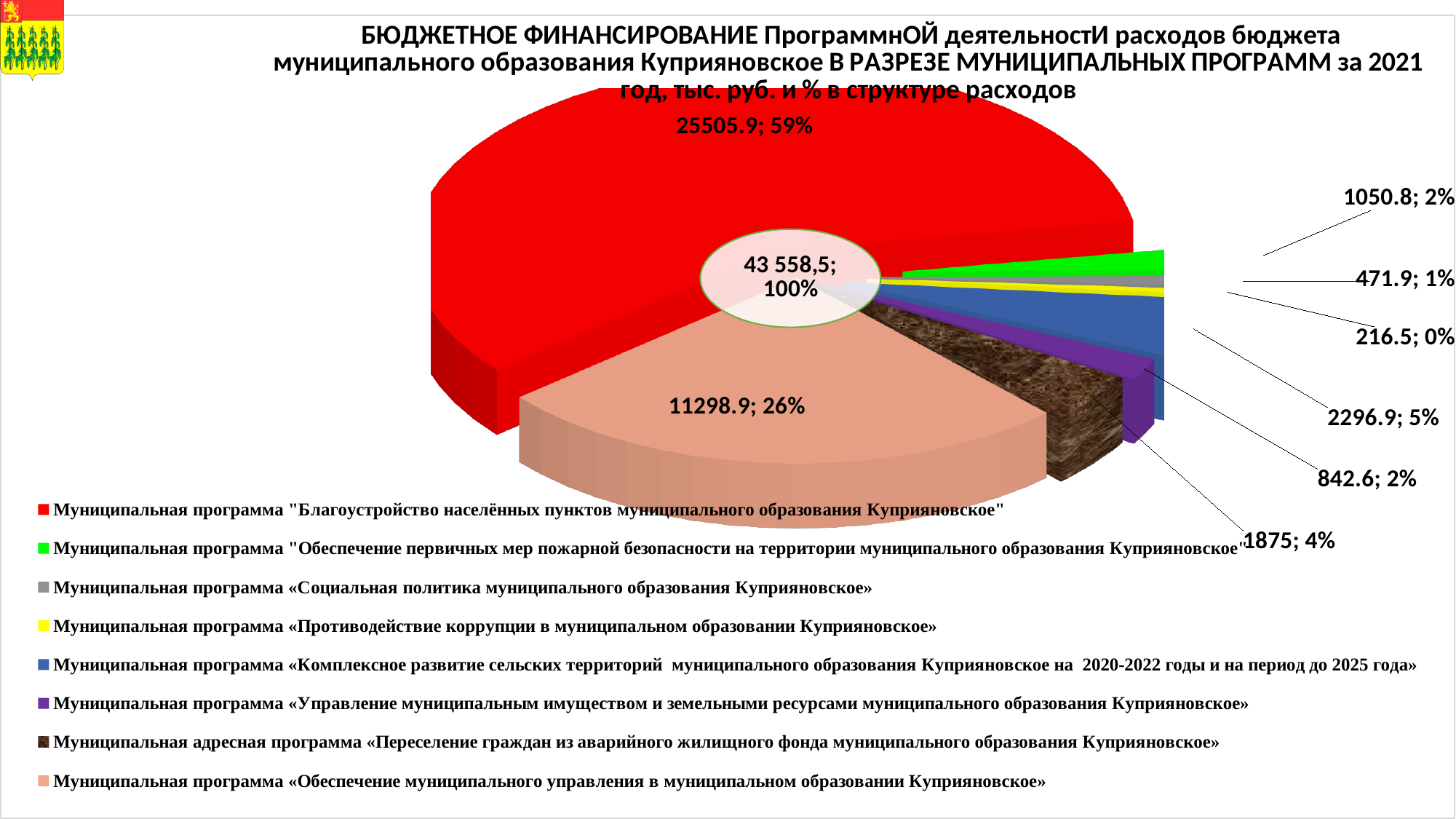
What total value is shown in the centre of the pie chart? 43 558,5; 100% Which is larger: the value for «Обеспечение первичных мер пожарной безопасности» or for «Управление муниципальным имуществом и земельными ресурсами»? Обеспечение первичных мер пожарной безопасности (1050.8) How many programs (slices) does the legend list? 8 What value and share are shown for the program "Благоустройство населённых пунктов муниципального образования Куприяновское"? 25505.9; 59% What is the difference between the values for "Благоустройство населённых пунктов" (25505.9) and «Обеспечение муниципального управления» (11298.9)? 14207 What share of expenditures does the program «Переселение граждан из аварийного жилищного фонда» account for? 4% What value is shown for the program «Комплексное развитие сельских территорий муниципального образования Куприяновское на 2020-2022 годы и на период до 2025 года»? 2296.9 What value and share are shown for the program «Обеспечение муниципального управления в муниципальном образовании Куприяновское»? 11298.9; 26% Which program has the smallest value on the chart? Муниципальная программа «Противодействие коррупции в муниципальном образовании Куприяновское» What kind of chart is shown on the slide? pie chart Which program has the largest share of the pie? Муниципальная программа "Благоустройство населённых пунктов муниципального образования Куприяновское" What colour represents the program «Социальная политика муниципального образования Куприяновское» in the legend? gray